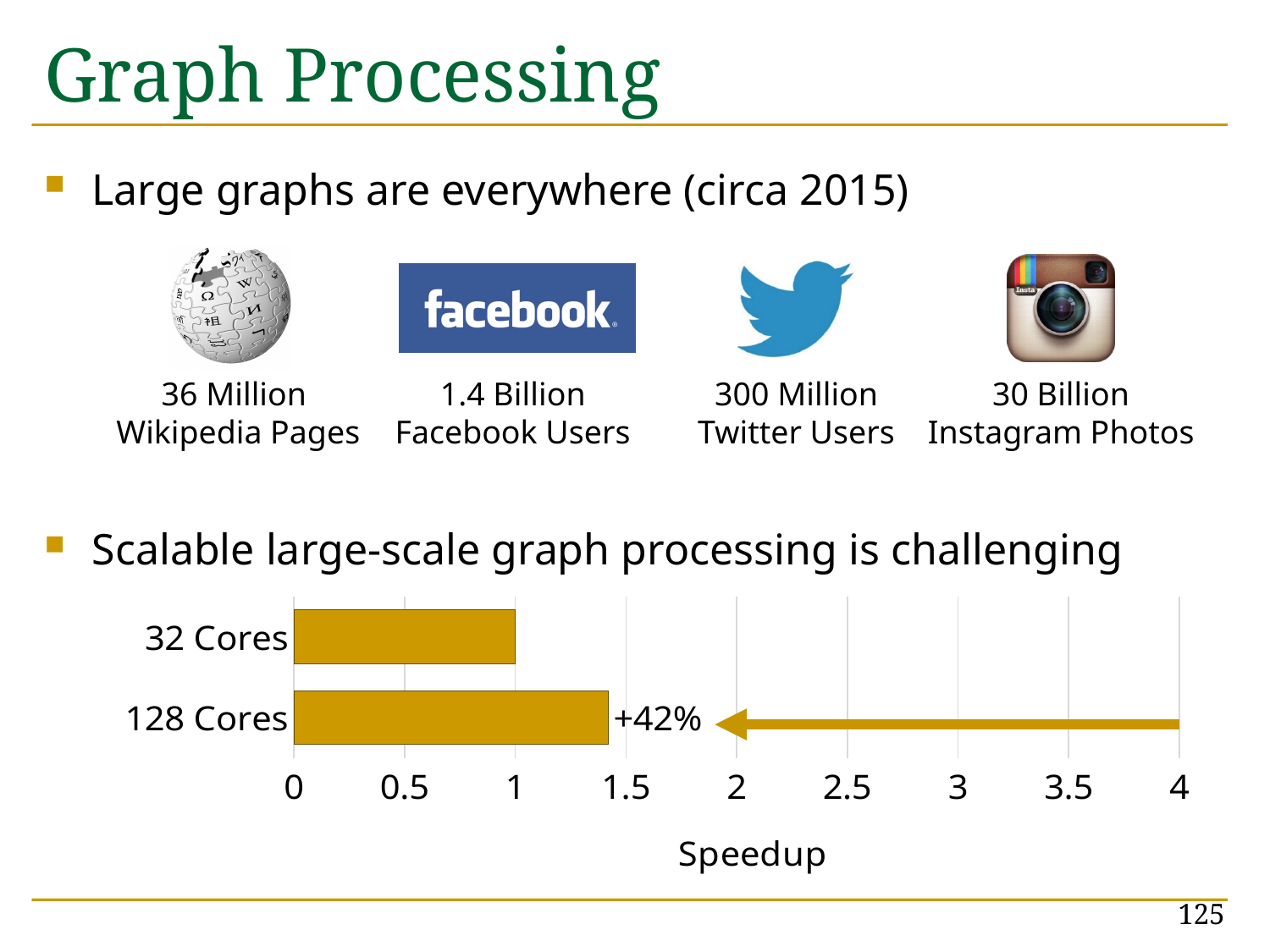
Is the speedup for 128 Cores greater or less than 2? less What annotation is printed next to the 128 Cores bar? +42% Which has a larger speedup, 32 Cores or 128 Cores? 128 Cores How many categories are plotted in the chart? 2 What is the label of the x axis of the chart? Speedup Which category has the highest speedup? 128 Cores What is the maximum value shown on the x axis? 4 Which category has the lowest speedup? 32 Cores What kind of chart is shown on the slide? bar chart Is the speedup for 128 Cores greater or less than 1? greater What is the speedup value for 32 Cores? 1